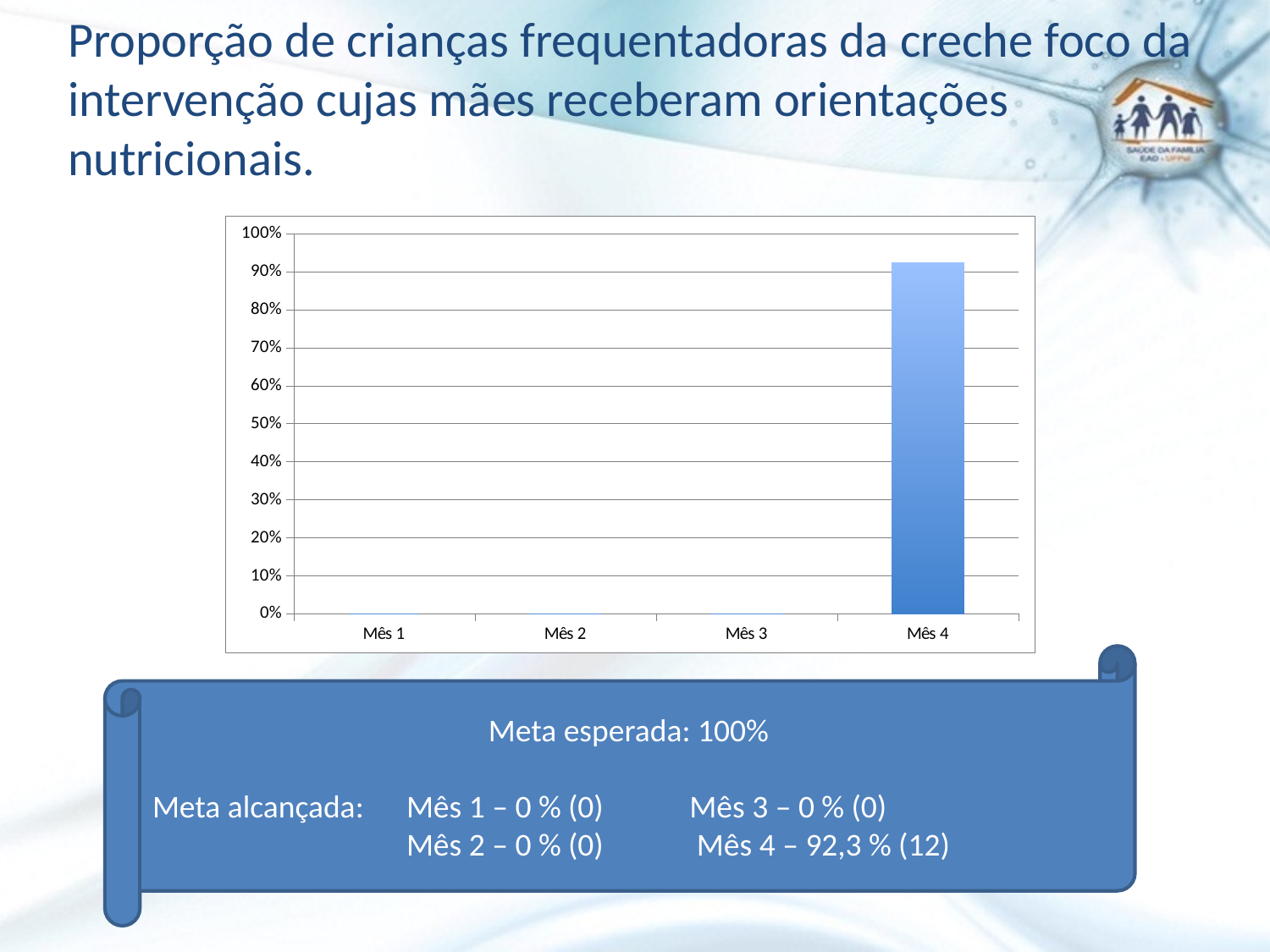
What is the highest tick shown on the y axis of the chart? 100% How many categories (months) are shown on the x axis of the chart? 4 What is the expected target (meta esperada) stated on the slide? 100% Which is larger, the value for Mês 2 or the value for Mês 4? Mês 4 What is the value for Mês 1 in the chart? 0% Which month has the highest value in the chart? Mês 4 According to the slide, what percentage was reached in Mês 4? 92,3 % Does the value rise or fall from Mês 3 to Mês 4? rise What kind of chart is shown on the slide? bar chart Is the value for Mês 4 greater or less than 100%? less Is the value for Mês 4 greater or less than 90%? greater What is the value for Mês 3 in the chart? 0%